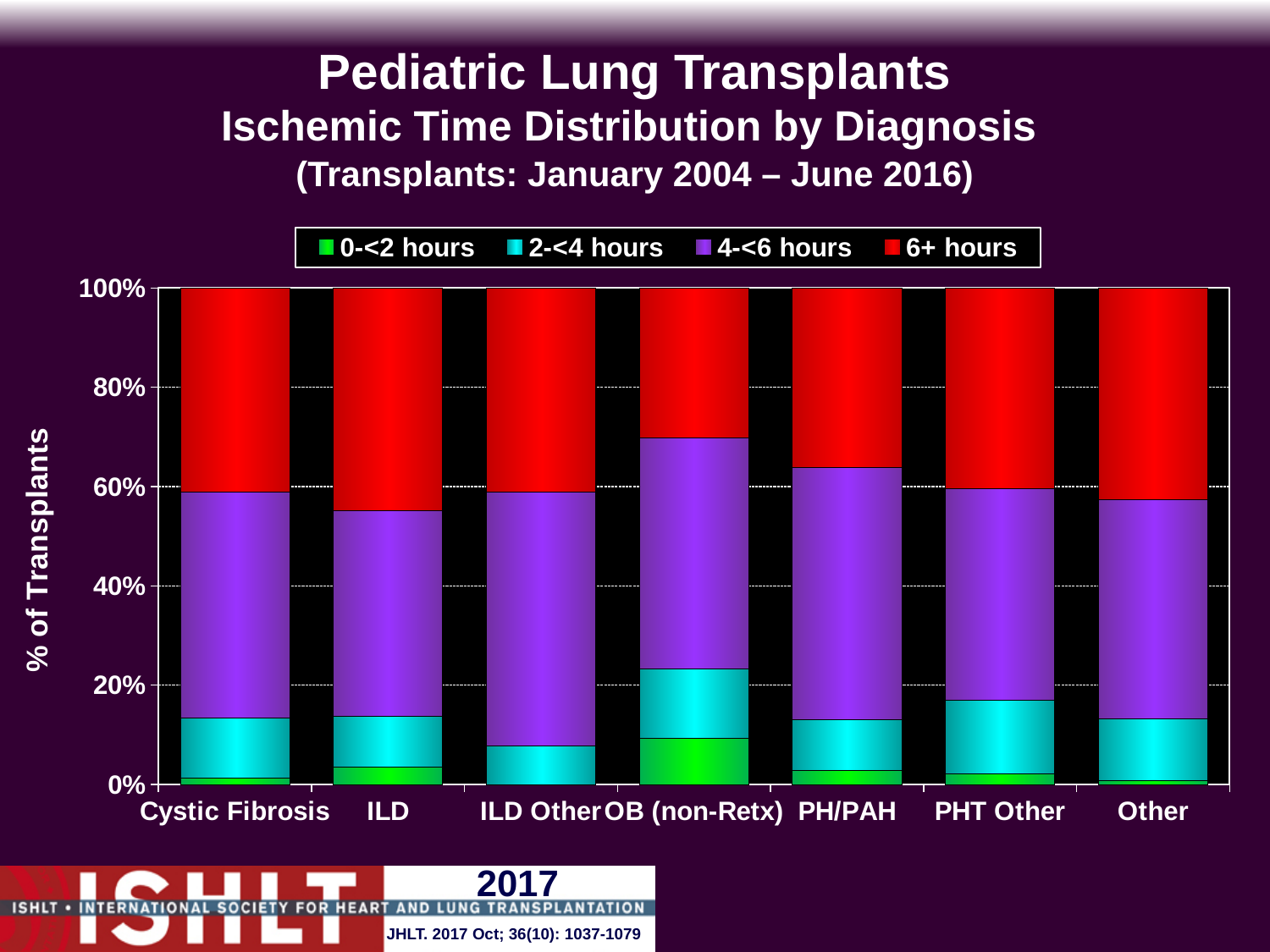
What kind of chart is shown on the slide? Stacked bar chart Which diagnosis category has the smallest share of transplants with 6+ hours ischemic time? OB (non-Retx) What is the label of the y axis? % of Transplants How many series does the legend list? 4 Which has the larger 0-<2 hours share, OB (non-Retx) or Cystic Fibrosis? OB (non-Retx) How many diagnosis categories are shown on the x axis? 7 Is the 6+ hours share for OB (non-Retx) greater or less than 40%? less Is the 4-<6 hours share for PH/PAH greater or less than 40%? greater Which diagnosis category has the largest share of transplants with 0-<2 hours ischemic time? OB (non-Retx) What is the total of the stacked bar for Cystic Fibrosis? 100% Is the 6+ hours share for ILD greater or less than 40%? greater Which series is shown in red in the legend? 6+ hours